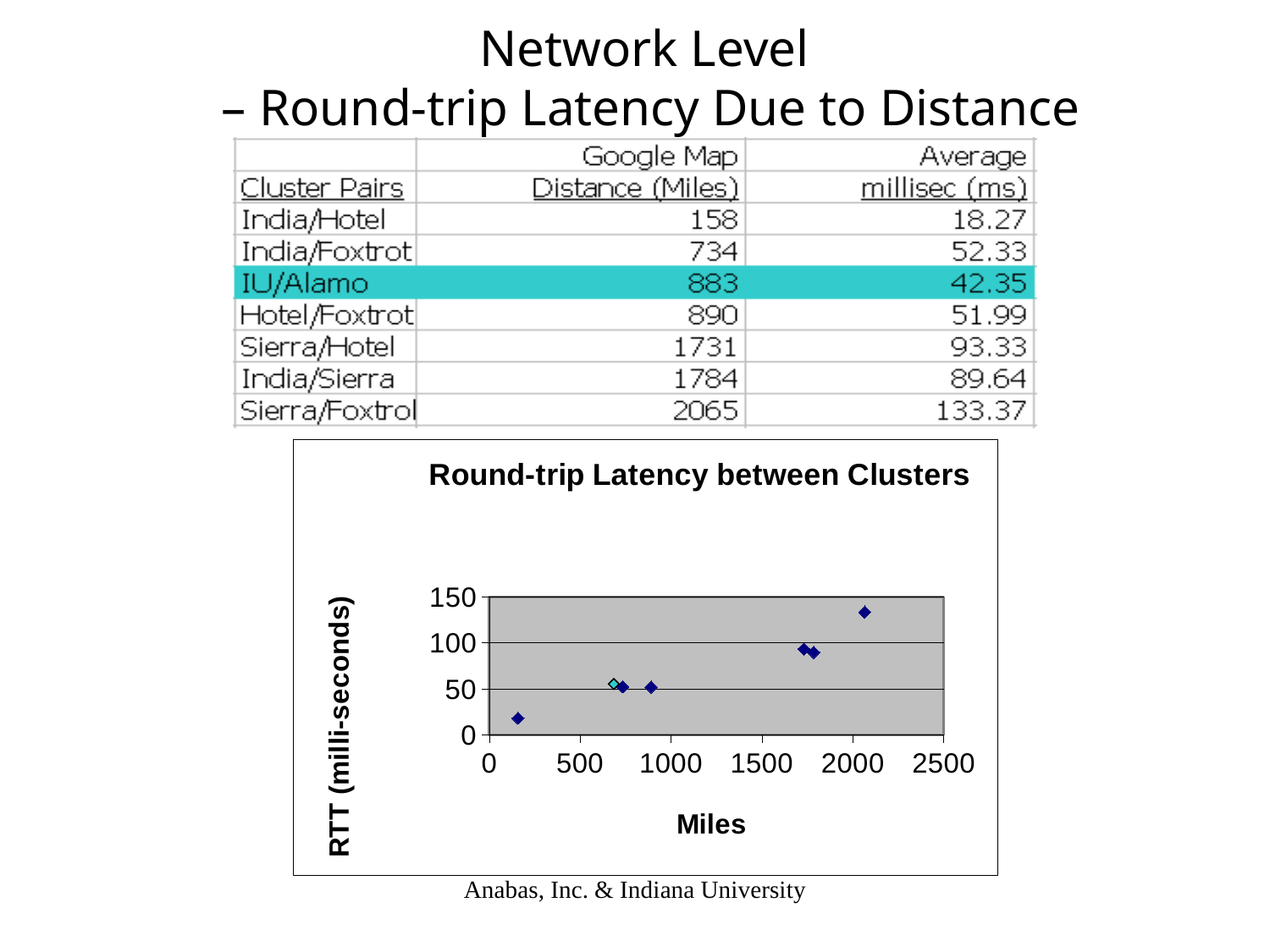
What is the label of the vertical axis of the chart? RTT (milli-seconds) What kind of chart is shown on the slide? Scatter chart How many data points are plotted in the chart? 7 What is the difference in average milliseconds between Sierra/Foxtrol and India/Hotel? 115.10 Is the RTT value for the point at about 2065 miles greater or less than 100? greater What is the title of the chart? Round-trip Latency between Clusters Does the round-trip latency generally rise or fall as the distance in miles increases? Rise Is the RTT value for the point at about 158 miles greater or less than 50? less What is the Google Map distance in miles for the Sierra/Hotel cluster pair? 1731 What is the average round-trip latency in milliseconds for the IU/Alamo cluster pair? 42.35 Which cluster pair has the highest average round-trip latency? Sierra/Foxtrol Which cluster pair has the lowest average round-trip latency? India/Hotel